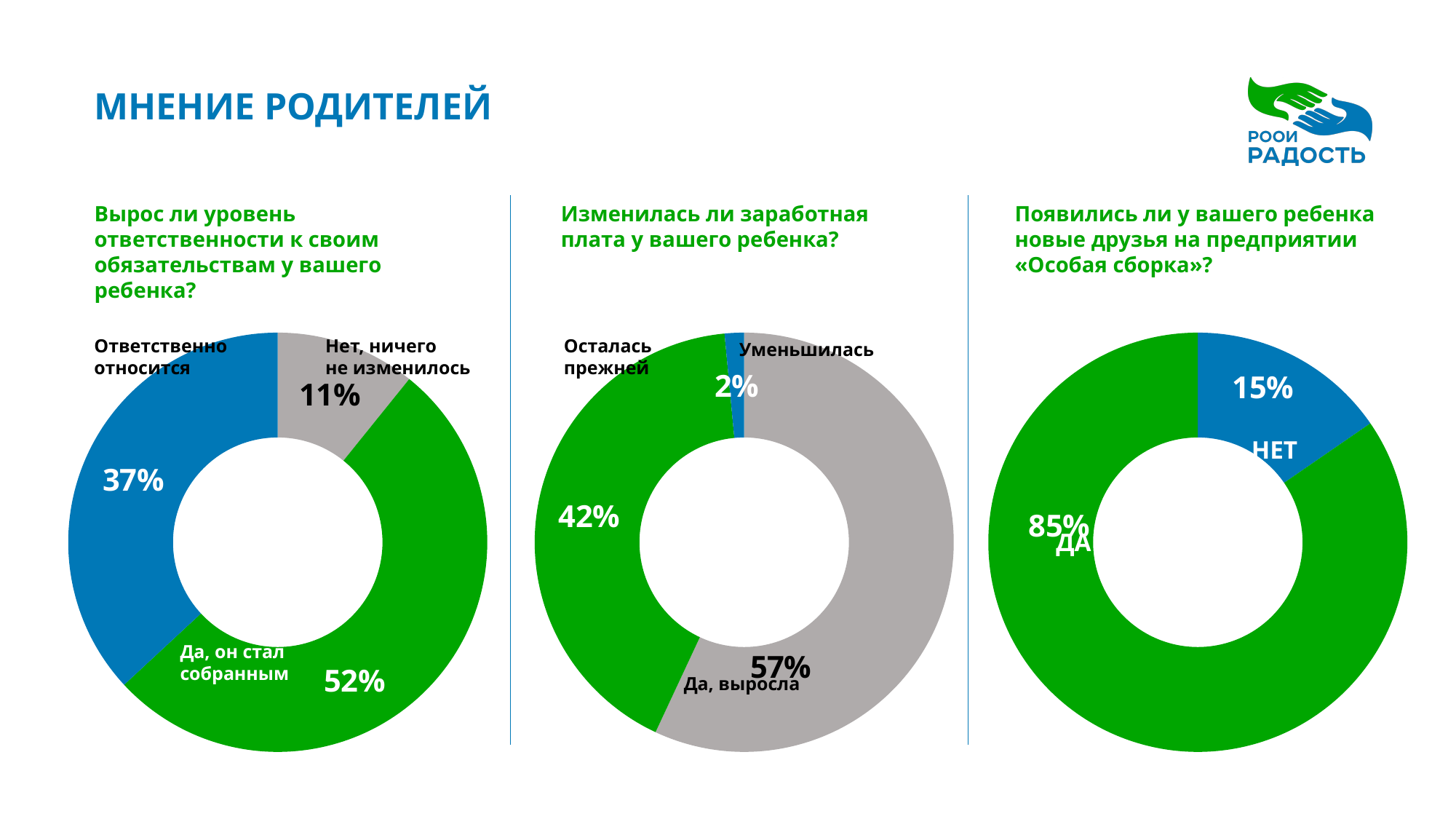
What type of chart is used for the three charts on the slide? Donut (pie) chart In the left chart ("Вырос ли уровень ответственности..."), what percentage corresponds to "Нет, ничего не изменилось"? 11% In the right chart ("Появились ли у вашего ребенка новые друзья..."), what colour is the "НЕТ" slice? Blue In the left chart ("Вырос ли уровень ответственности..."), what is the difference between the shares for "Да, он стал собранным" and "Ответственно относится"? 15 percentage points In the middle chart ("Изменилась ли заработная плата у вашего ребенка?"), what share answered "Да, выросла"? 57% In the right chart ("Появились ли у вашего ребенка новые друзья..."), what is the difference between the "ДА" and "НЕТ" shares? 70 percentage points In the right chart ("Появились ли у вашего ребенка новые друзья на предприятии «Особая сборка»?"), what share answered "ДА"? 85% How many slices does the middle chart ("Изменилась ли заработная плата...") have? 3 In the middle chart ("Изменилась ли заработная плата..."), which is larger: "Осталась прежней" or "Да, выросла"? Да, выросла In the middle chart ("Изменилась ли заработная плата..."), which answer has the smallest share? Уменьшилась In the left chart ("Вырос ли уровень ответственности..."), which answer has the largest share? Да, он стал собранным In the left chart ("Вырос ли уровень ответственности к своим обязательствам у вашего ребенка?"), what share of parents answered "Да, он стал собранным"? 52%